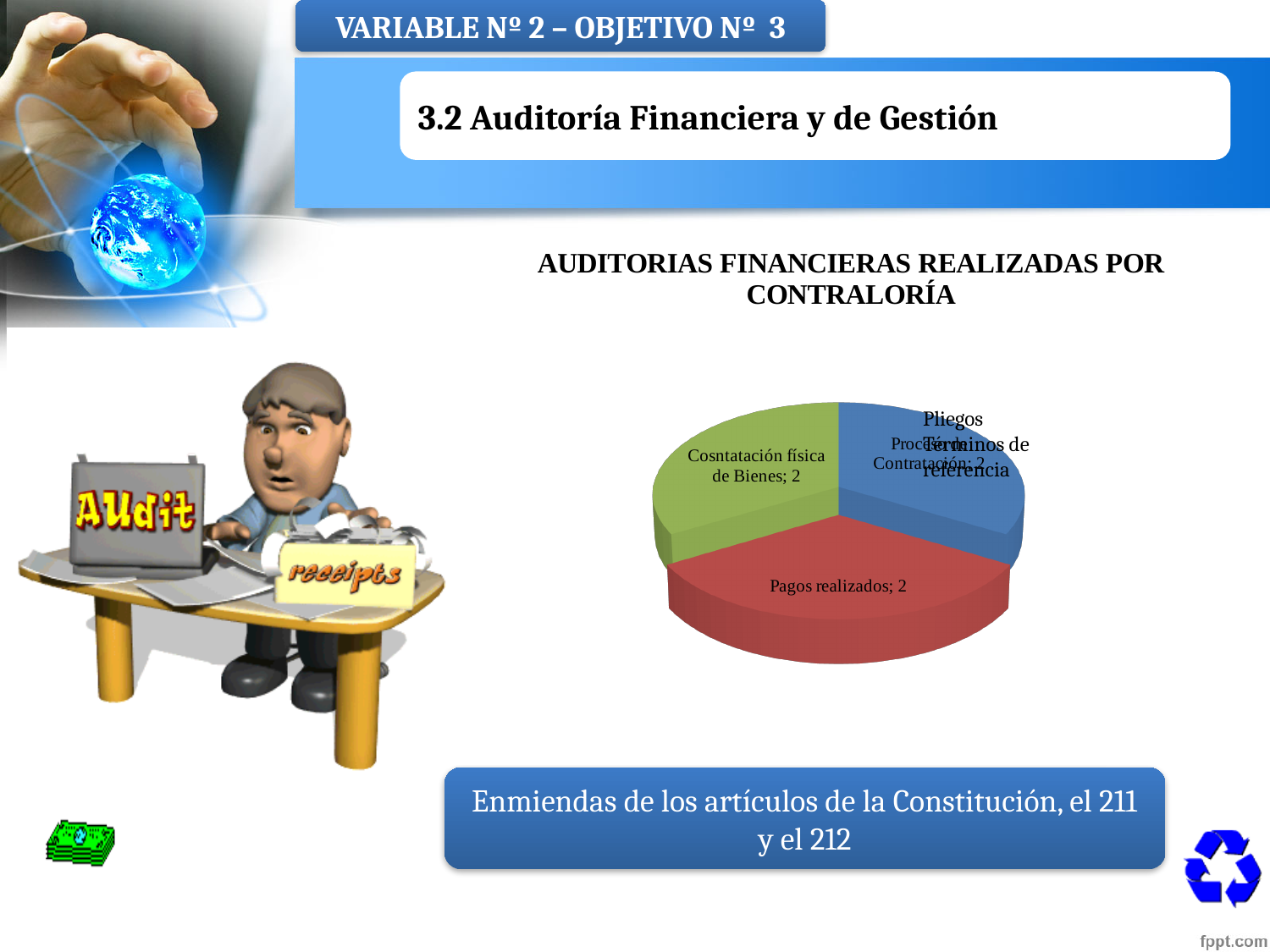
What colour is the "Pagos realizados" slice in the pie chart? Red What is the difference between the values for "Pagos realizados" and "Cosntatación física de Bienes"? 0 How many slices does the pie chart have? 3 What is the total of all slices in the pie chart? 6 What is the value for "Cosntatación física de Bienes" in the pie chart? 2 What is the value for "Pagos realizados" in the pie chart? 2 What is the title of the chart on the slide? AUDITORIAS FINANCIERAS REALIZADAS POR CONTRALORÍA What type of chart is shown on the slide? Pie chart Which is larger, the value for "Pagos realizados" or the value for "Cosntatación física de Bienes"? They are equal What share of the pie does "Pagos realizados" represent? One third (2 of 6)